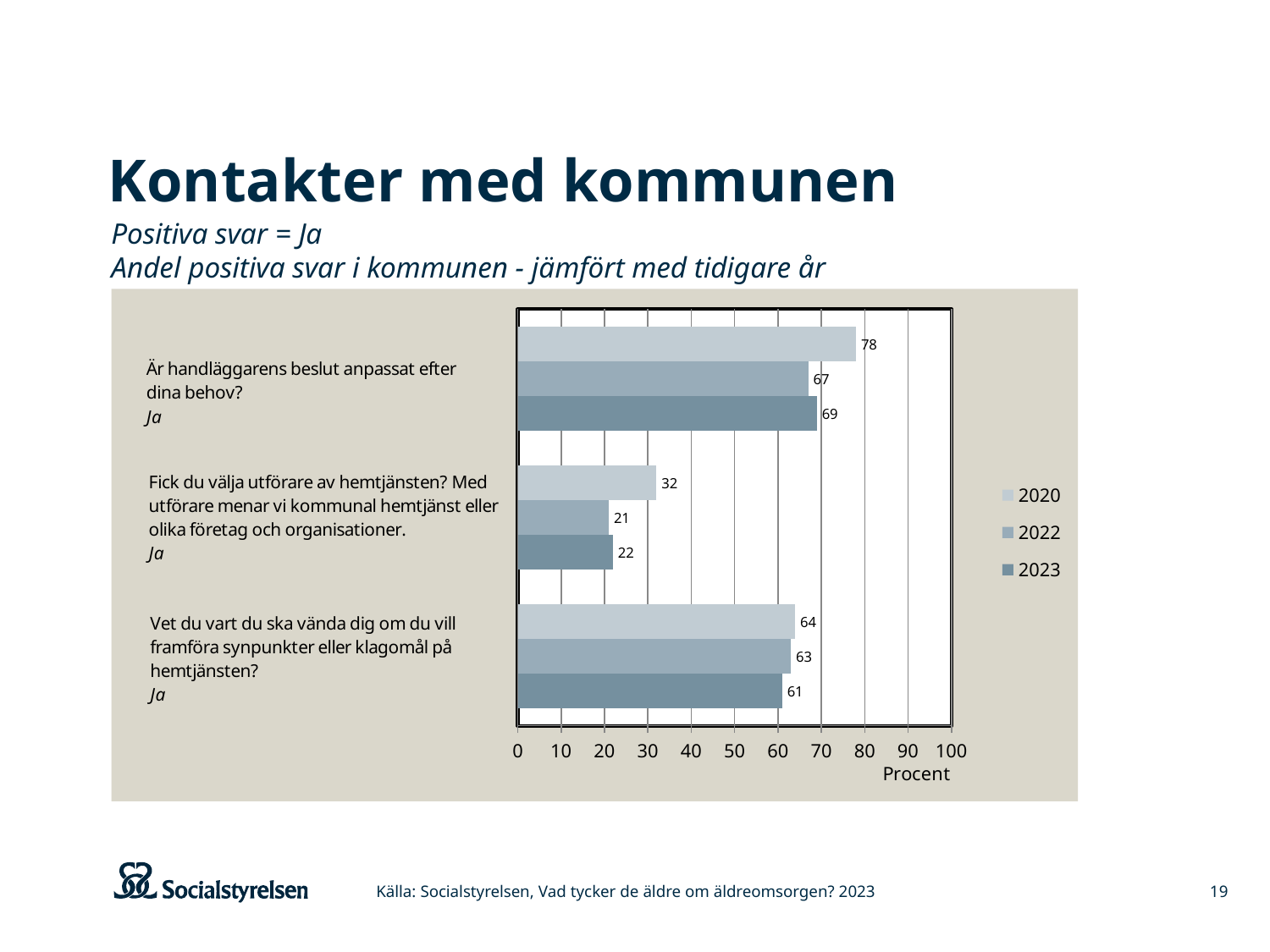
Is the 2023 value for "Är handläggarens beslut anpassat efter dina behov?" greater or less than 60? greater How many question categories are plotted in the chart? 3 How many series does the legend list? 3 Which year has the highest value for "Är handläggarens beslut anpassat efter dina behov?"? 2020 Which year has the lowest value for "Fick du välja utförare av hemtjänsten?"? 2022 What is the difference between the 2020 and 2022 values for "Fick du välja utförare av hemtjänsten?"? 11 Which is larger for "Vet du vart du ska vända dig om du vill framföra synpunkter eller klagomål på hemtjänsten?": the 2020 value or the 2023 value? 2020 What is the 2022 value for "Vet du vart du ska vända dig om du vill framföra synpunkter eller klagomål på hemtjänsten?"? 63 What is the 2020 value for "Är handläggarens beslut anpassat efter dina behov?"? 78 What is the label on the horizontal axis of the chart? Procent What kind of chart is shown on the slide? bar chart What is the 2023 value for "Fick du välja utförare av hemtjänsten?"? 22